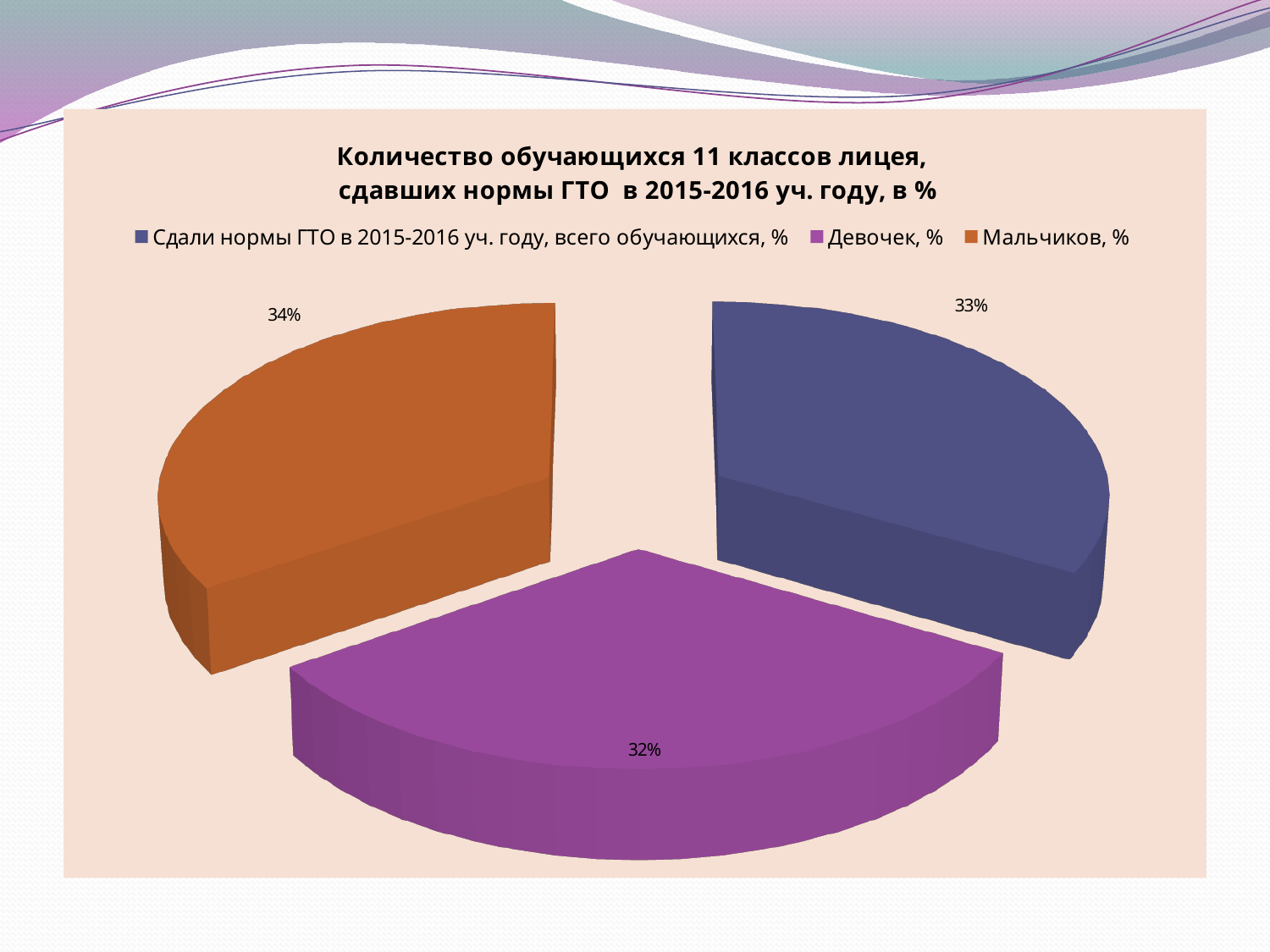
What is the value shown for the slice "Сдали нормы ГТО в 2015-2016 уч. году, всего обучающихся, %"? 33% How many entries does the legend list? 3 What is the value shown for the slice "Девочек, %"? 32% Which is larger, the value for "Мальчиков, %" or the value for "Сдали нормы ГТО в 2015-2016 уч. году, всего обучающихся, %"? Мальчиков, % What is the title of the chart? Количество обучающихся 11 классов лицея, сдавших нормы ГТО в 2015-2016 уч. году, в % Which slice has the smallest value? Девочек, % What colour is the slice for "Девочек, %"? purple What is the difference between the values for "Мальчиков, %" and "Девочек, %"? 2% How many slices does the pie chart have? 3 Which slice has the largest value? Мальчиков, % What is the value shown for the slice "Мальчиков, %"? 34% What kind of chart is shown on the slide? pie chart